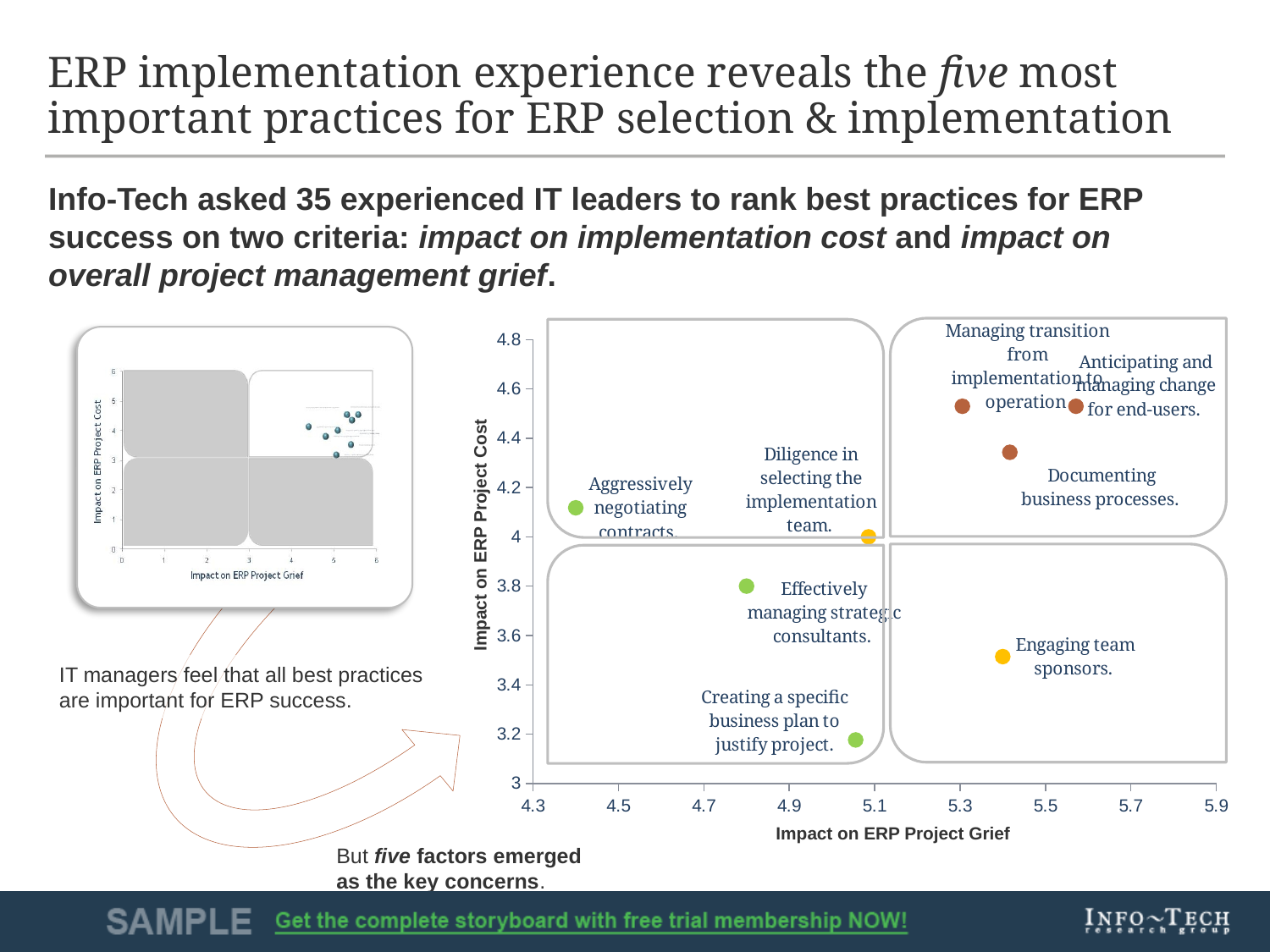
In the large chart on the right, what is the title of the y axis? Impact on ERP Project Cost In the large chart on the right, how many data points are plotted? 8 In the large chart on the right, what is the title of the x axis? Impact on ERP Project Grief In the large chart on the right, which practice has the highest Impact on ERP Project Grief? Anticipating and managing change for end-users. In the large chart on the right, which has the higher Impact on ERP Project Cost: 'Documenting business processes' or 'Engaging team sponsors'? Documenting business processes What kind of chart is the large chart on the right of the slide? scatter chart In the large chart on the right, is the Impact on ERP Project Cost for 'Creating a specific business plan to justify project' greater or less than 3.4? less In the large chart on the right, is the Impact on ERP Project Grief for 'Aggressively negotiating contracts' greater or less than 4.5? less In the large chart on the right, which practice has the lowest Impact on ERP Project Grief? Aggressively negotiating contracts. In the large chart on the right, which practice has the lowest Impact on ERP Project Cost? Creating a specific business plan to justify project. In the large chart on the right, is the Impact on ERP Project Grief for 'Engaging team sponsors' greater or less than 5.3? greater